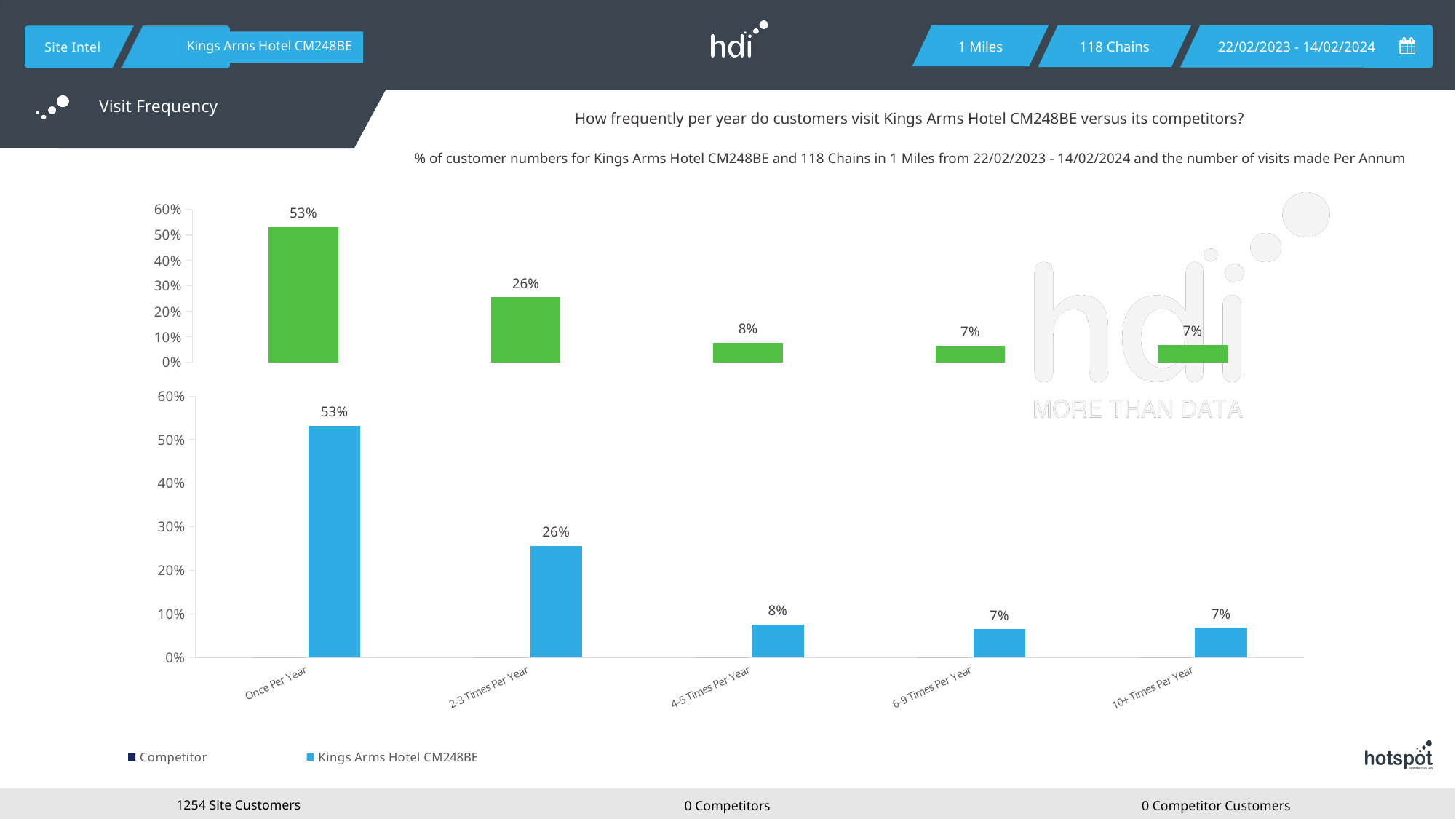
In the bottom chart, what is the value for 10+ Times Per Year? 7% In the bottom chart, do the values generally rise or fall from Once Per Year to 10+ Times Per Year? Fall In the bottom chart, which visit frequency category has the highest value? Once Per Year How many series does the legend at the bottom of the slide list? 2 What type of chart is the bottom chart? Bar chart How many visit frequency categories are shown on the x axis of the bottom chart? 5 In the bottom chart, what percentage of customers visit Once Per Year? 53% In the bottom chart, what is the difference between the values for Once Per Year and 2-3 Times Per Year? 27% In the bottom chart, what is the value for 4-5 Times Per Year? 8% In the bottom chart, what is the value for 2-3 Times Per Year? 26% In the bottom chart, which is larger: the value for 2-3 Times Per Year or the value for 4-5 Times Per Year? 2-3 Times Per Year In the bottom chart, is the value for Once Per Year greater or less than 50%? greater